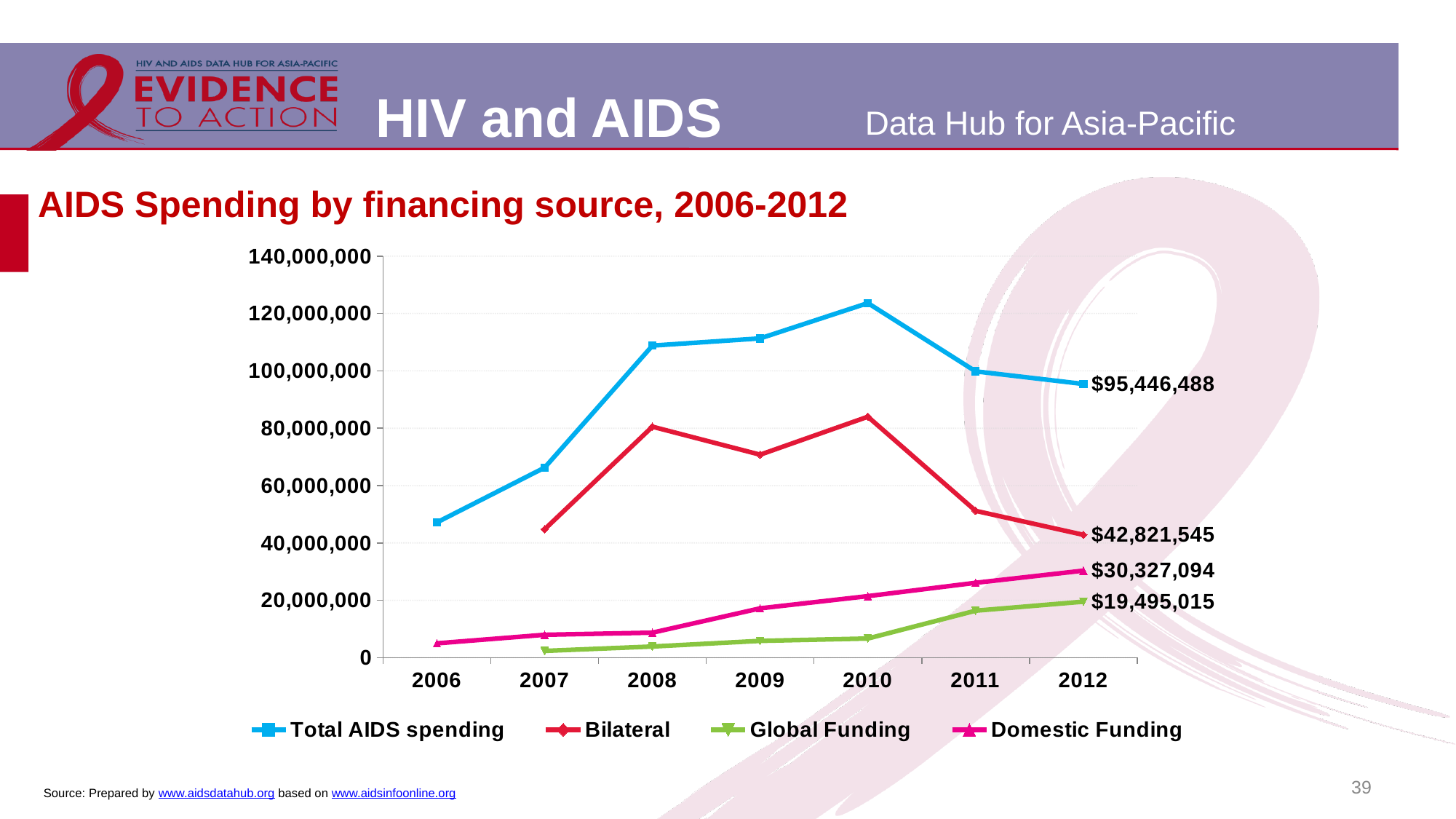
What is the value for Total AIDS spending in 2012? $95,446,488 In which year does Total AIDS spending reach its highest value? 2010 What is the value for Bilateral in 2012? $42,821,545 How many series does the legend list? 4 Is the value for Total AIDS spending in 2010 greater or less than 120,000,000? greater What kind of chart is shown on the slide? Line chart What is the value for Global Funding in 2012? $19,495,015 How many years are shown on the x axis? 7 Which is larger in 2012, Bilateral or Domestic Funding? Bilateral What is the difference between Total AIDS spending and Bilateral in 2012? $52,624,943 In which year is Total AIDS spending at its lowest? 2006 What is the value for Domestic Funding in 2012? $30,327,094